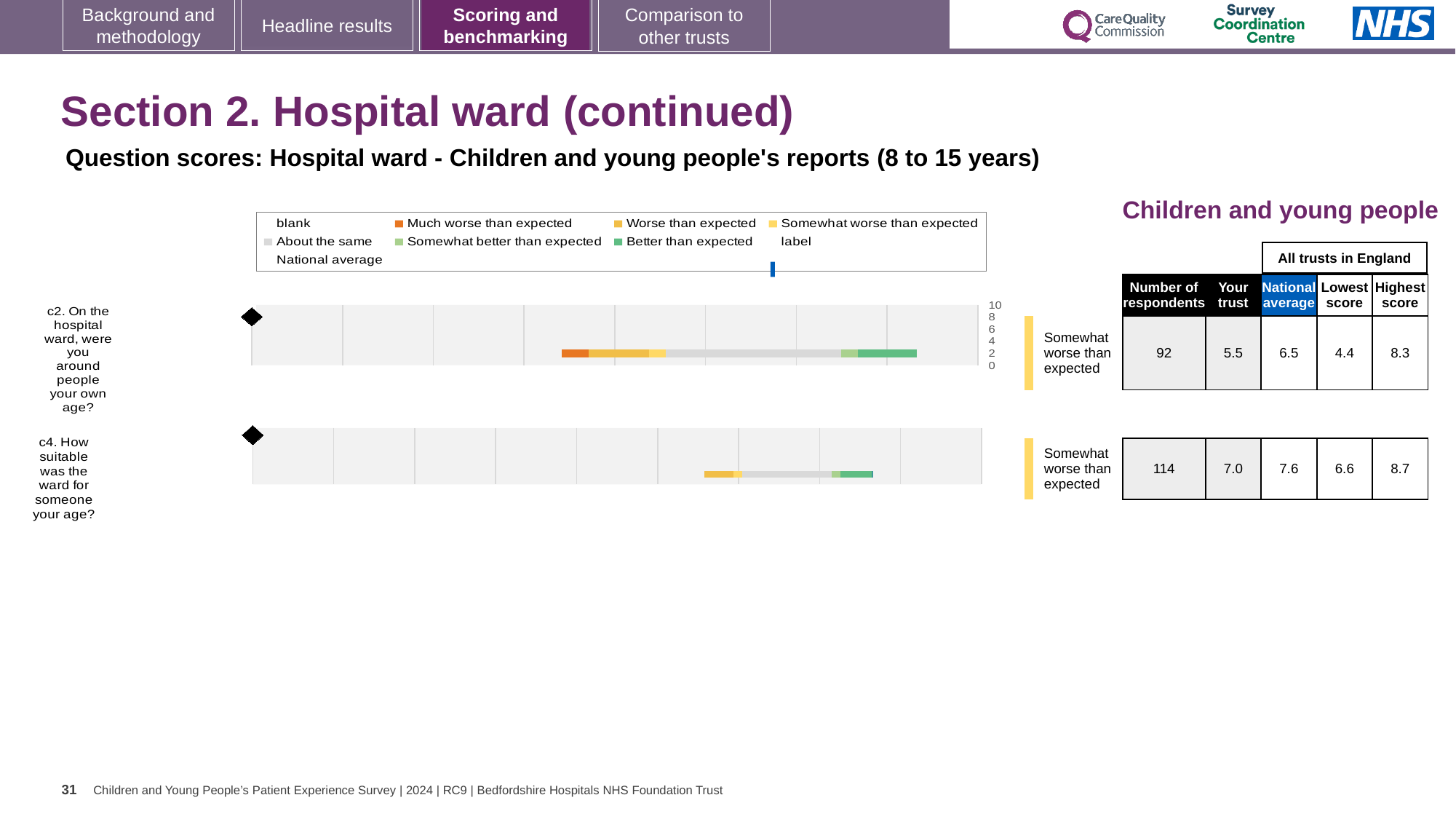
What is the difference between the highest and lowest scores for question c4? 2.1 What is the national average score for question c4 (How suitable was the ward for someone your age?)? 7.6 Which legend entry is shown in orange? Much worse than expected What is the lowest score among all trusts in England for question c4? 6.6 What is the highest score among all trusts in England for question c2? 8.3 How many respondents answered question c4? 114 Which question has the higher 'Your trust' score, c2 or c4? c4 What benchmarking category is shown for question c2? Somewhat worse than expected How many questions are plotted on the slide? 2 What is the difference between the national average and the 'Your trust' score for question c2? 1.0 What is the 'Your trust' score for question c2 (On the hospital ward, were you around people your own age?)? 5.5 What kind of chart is used to show the question scores on this slide? Bar chart